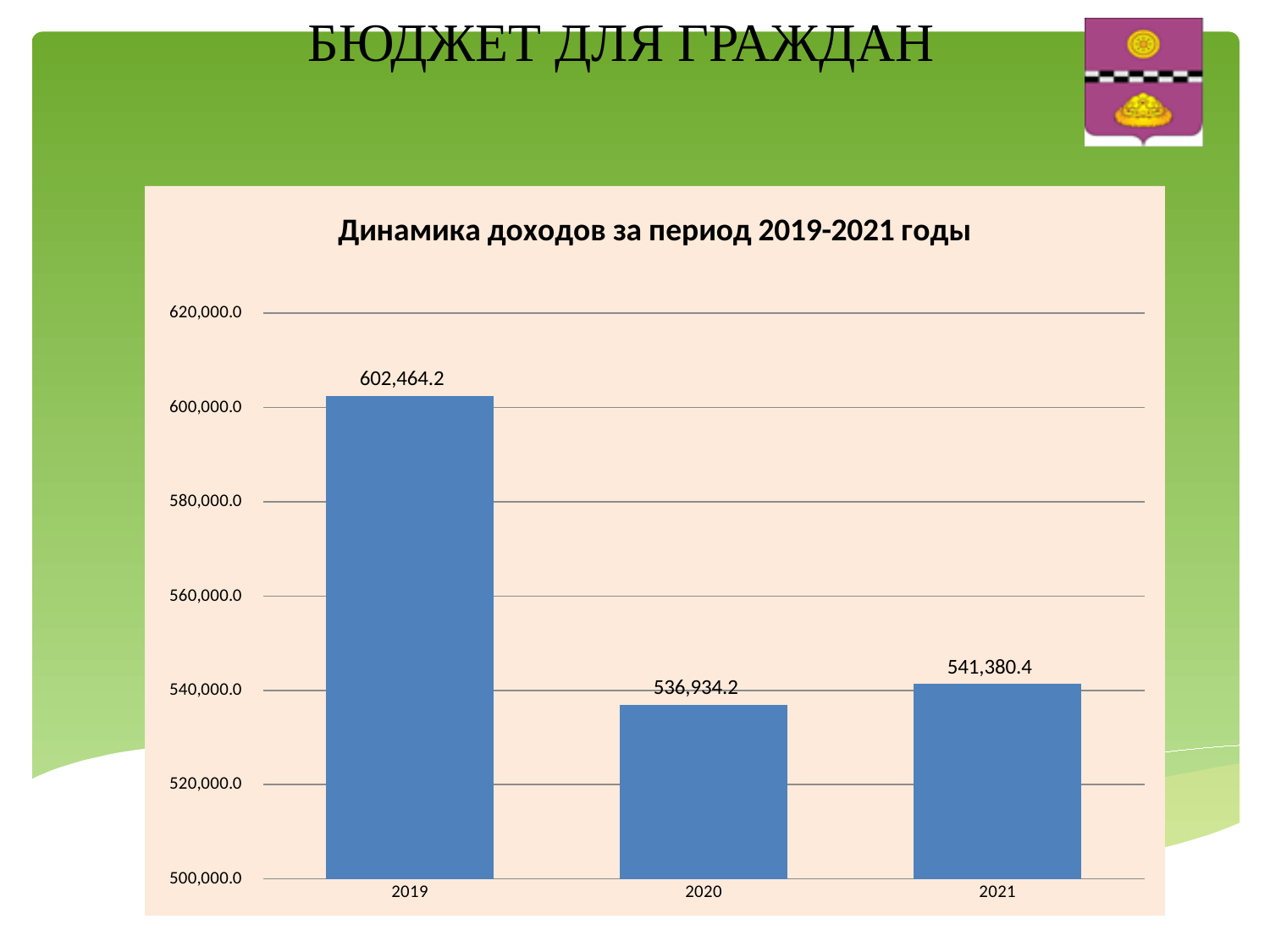
Which year has the lowest value? 2020 Is the value for 2019 greater or less than 600,000.0? greater What is the value for 2020? 536,934.2 What is the value for 2021? 541,380.4 What is the difference between the values for 2021 and 2020? 4,446.2 What is the difference between the values for 2019 and 2020? 65,530.0 How many years are shown on the x axis? 3 What kind of chart is this? bar chart What is the title of the chart? Динамика доходов за период 2019-2021 годы Which is larger, the value for 2020 or the value for 2021? 2021 Which year has the highest value? 2019 What is the value for 2019? 602,464.2